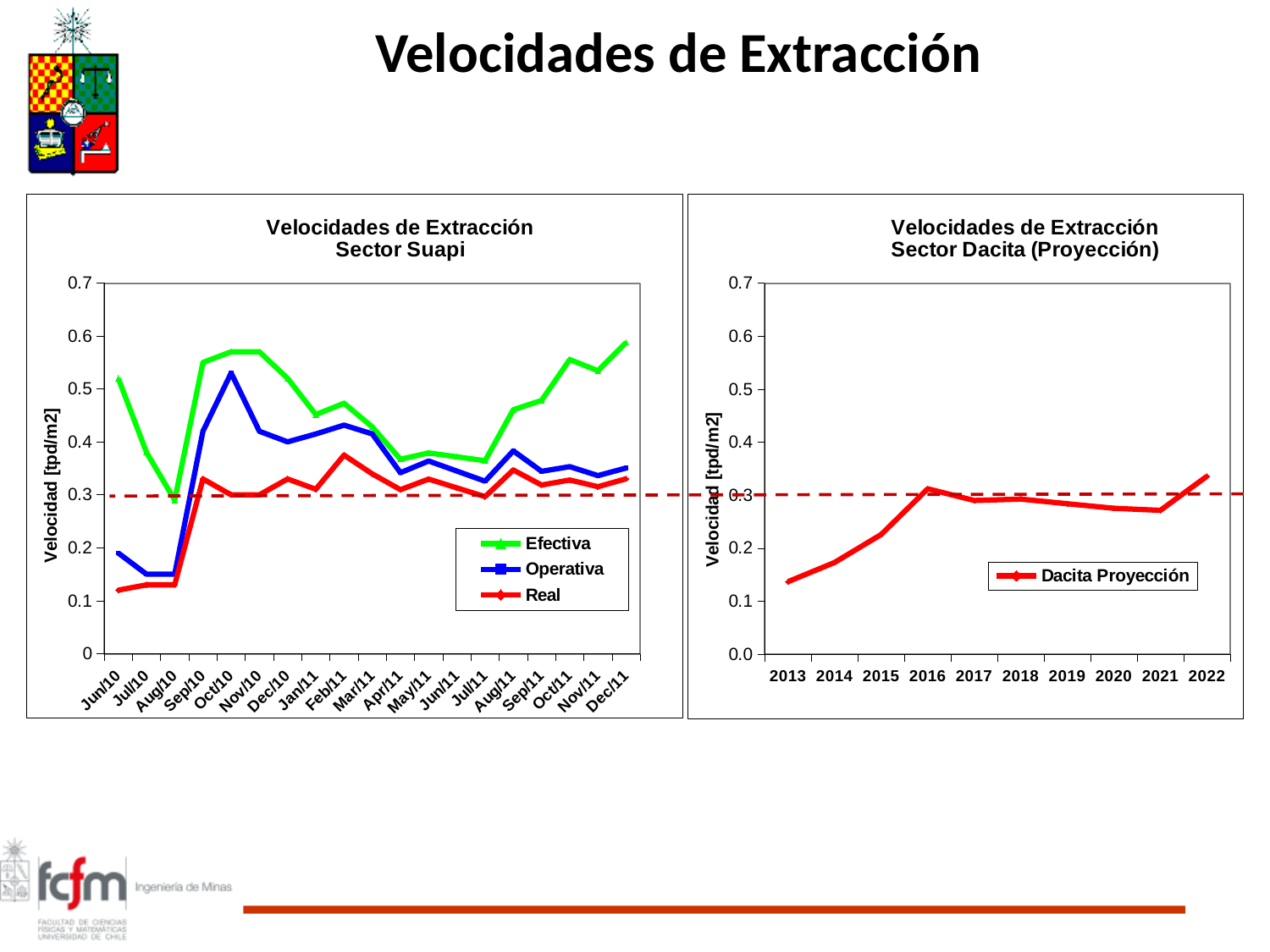
In the 'Sector Suapi' chart, is the Efectiva value for Jun/10 greater or less than 0.5? greater In the 'Sector Dacita (Proyección)' chart, does the value rise or fall from 2013 to 2016? rise In the 'Sector Dacita (Proyección)' chart, how many years are shown on the x axis? 10 In the 'Sector Suapi' chart, how many months are shown on the x axis? 19 In the 'Sector Suapi' chart, which series is higher in Oct/10, Efectiva or Real? Efectiva In the 'Sector Dacita (Proyección)' chart, is the value for 2022 greater or less than 0.3? greater In the 'Sector Suapi' chart, in which month does the Operativa series reach its highest value? Oct/10 In the 'Sector Suapi' chart, in which month does the Real series reach its highest value? Feb/11 What type of chart is the 'Velocidades de Extracción Sector Suapi' chart? line chart How many series does the legend of the 'Sector Suapi' chart list? 3 In the 'Sector Suapi' chart, is the Real value for Jun/10 greater or less than 0.2? less In the 'Sector Dacita (Proyección)' chart, which year has the lowest value? 2013